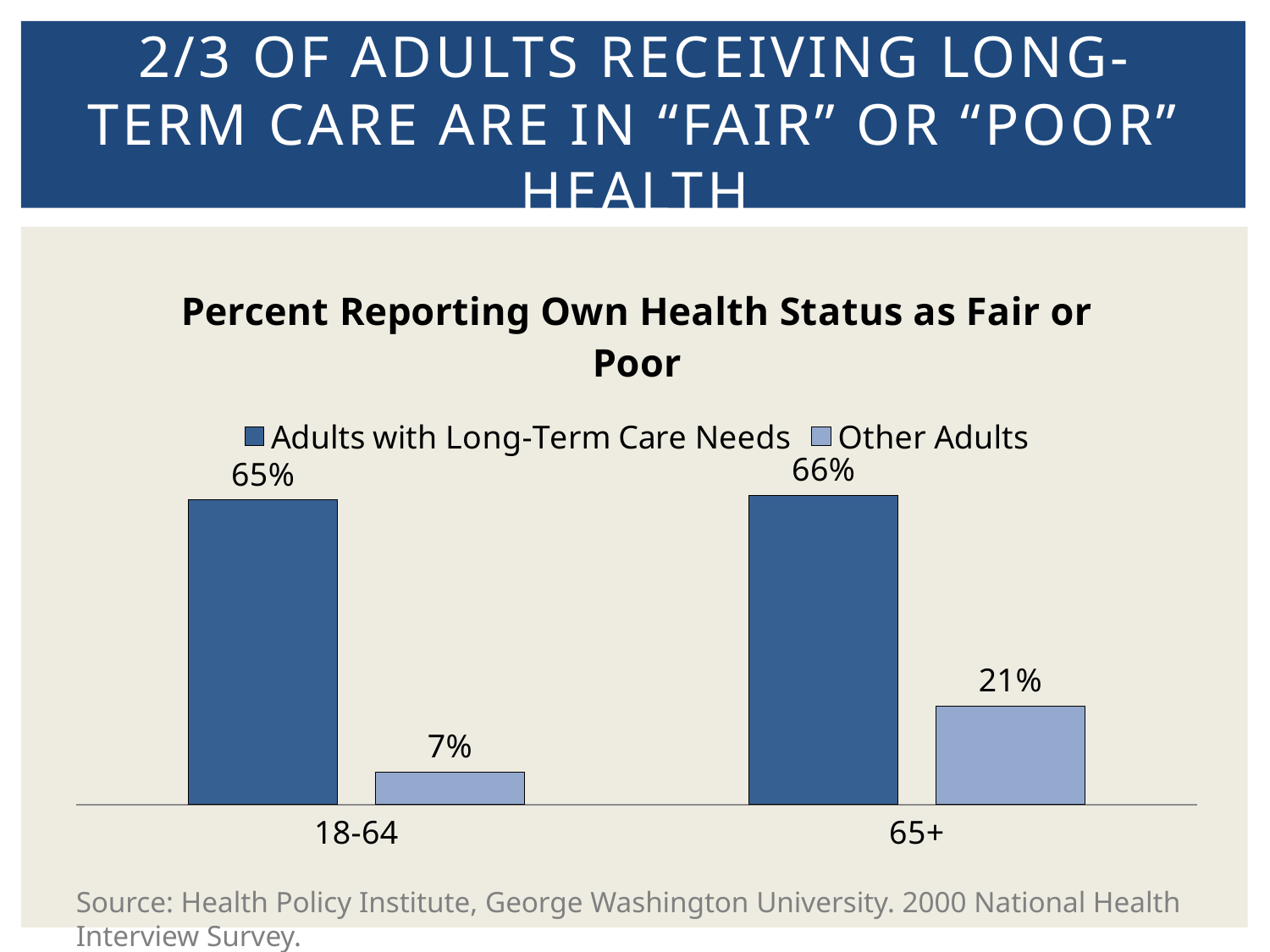
What kind of chart is shown on the slide? Bar chart How many age groups are shown on the x axis? 2 What percent of adults with long-term care needs aged 18-64 report their health status as fair or poor? 65% What is the value for Adults with Long-Term Care Needs in the 65+ age group? 66% What is the value for Other Adults in the 18-64 age group? 7% What is the difference between Adults with Long-Term Care Needs and Other Adults in the 65+ age group? 45% Which bar on the chart has the lowest value? Other Adults, 18-64 In the 65+ age group, which series has the larger value: Adults with Long-Term Care Needs or Other Adults? Adults with Long-Term Care Needs How many series does the legend list? 2 Which age group has the highest value for Other Adults? 65+ What is the difference between Adults with Long-Term Care Needs and Other Adults in the 18-64 age group? 58% What percent of other adults aged 65+ report their health status as fair or poor? 21%